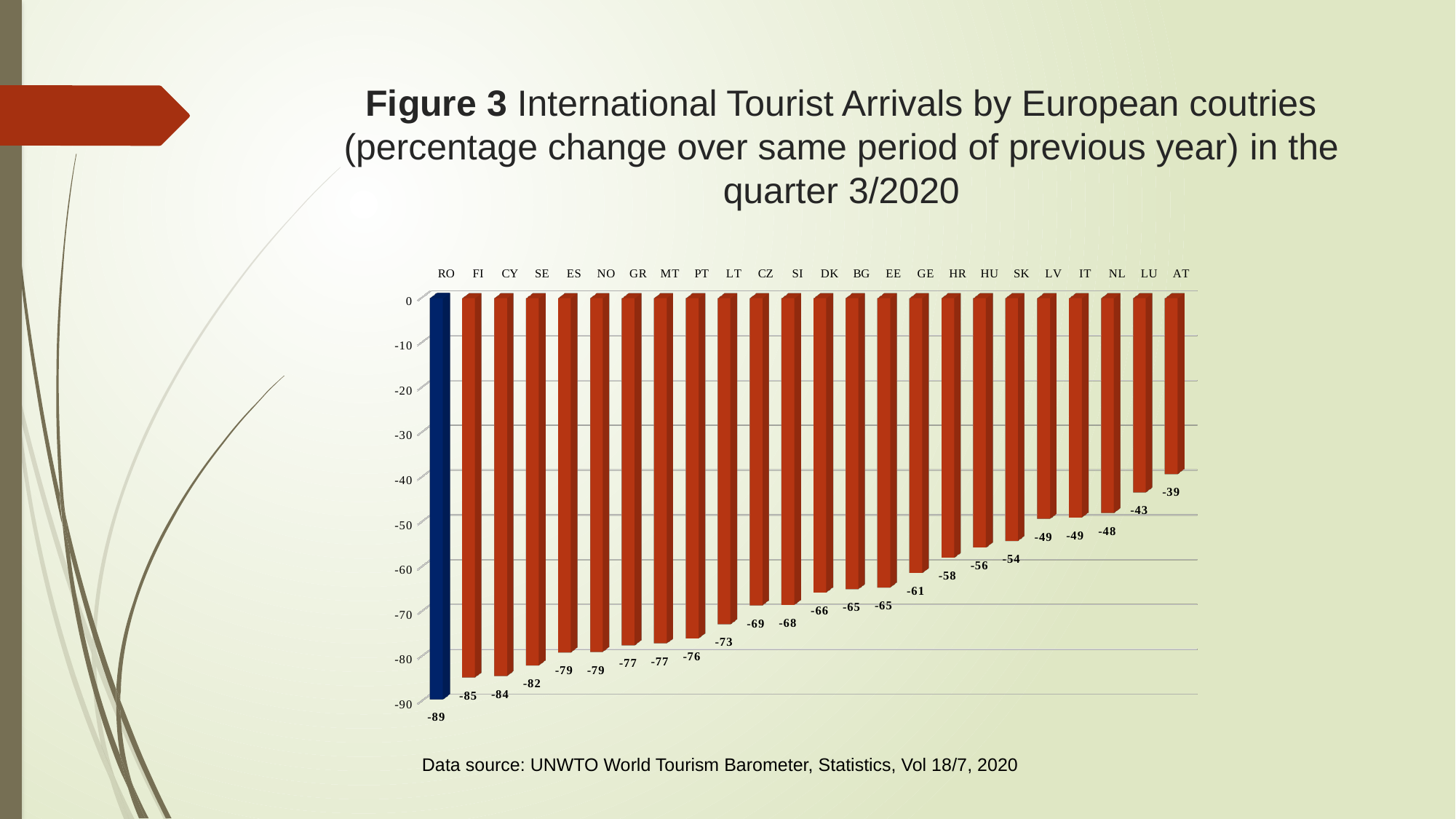
What is the difference between the values for FI and LU? 42 What is the difference between the values for RO and AT? 50 What is the value for AT? -39 What kind of chart is this? Bar chart Which has a larger decline, CZ or GE? CZ What is the value for HU? -56 Which country's bar is coloured differently (blue) from the others? RO Which country has the highest value (smallest decline)? AT What is the value for PT? -76 What is the value for RO? -89 Which country has the lowest value (largest decline)? RO How many countries are shown in the chart? 24